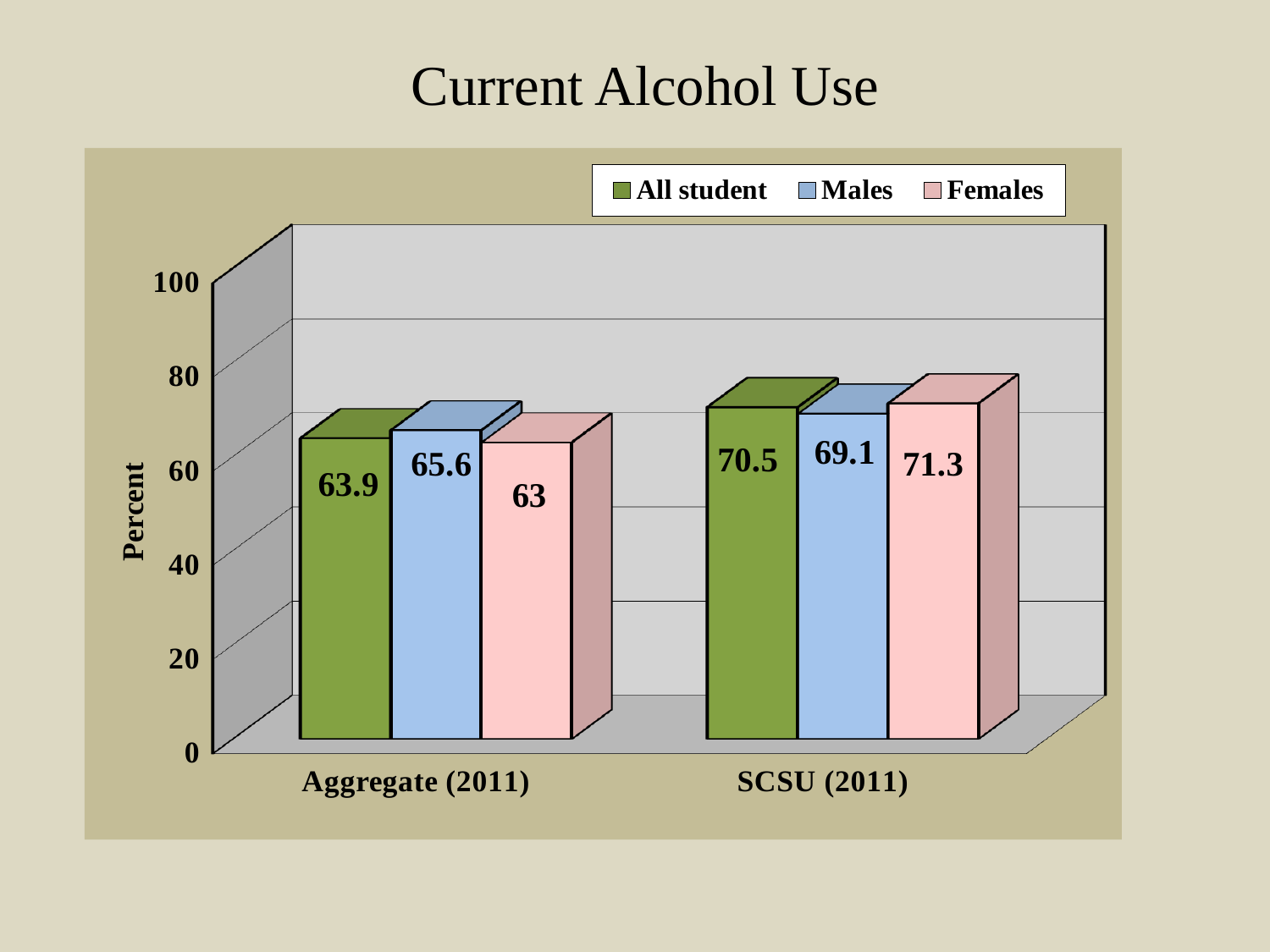
What is the difference between the All student values for SCSU (2011) and Aggregate (2011)? 6.6 How many categories are shown on the x axis? 2 What is the value for Males in the Aggregate (2011) group? 65.6 How many series does the legend list? 3 What is the title of the chart? Current Alcohol Use Which is larger: the Males value for Aggregate (2011) or the Males value for SCSU (2011)? SCSU (2011) Which series has the highest value in the SCSU (2011) group? Females What kind of chart is this? Bar chart What is the label on the vertical axis? Percent What is the value for All student in the SCSU (2011) group? 70.5 What is the value for Females in the SCSU (2011) group? 71.3 Which series has the lowest value in the Aggregate (2011) group? Females